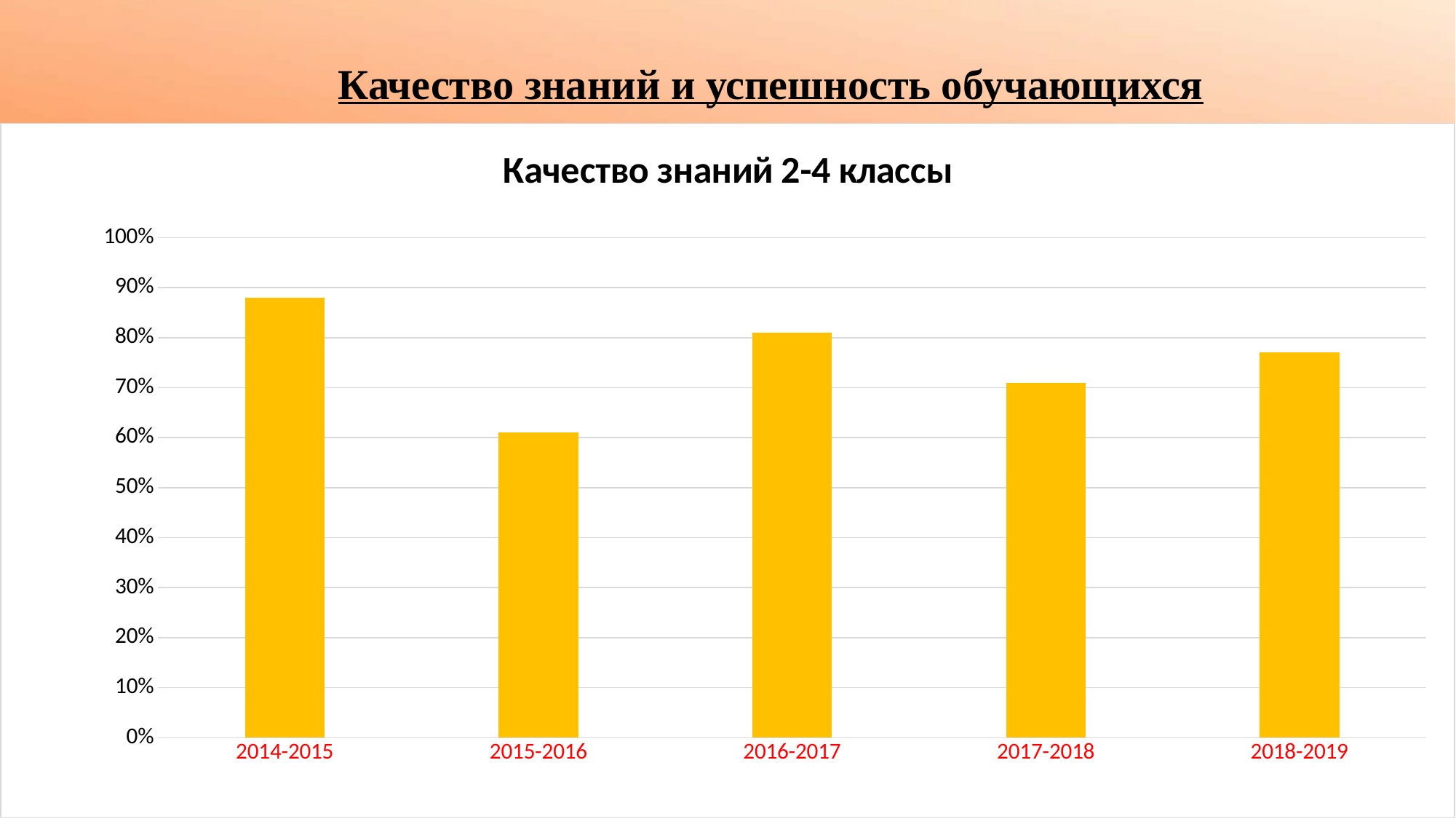
Which school year has the lowest value in the chart? 2015-2016 How many school years are shown on the x axis of the chart? 5 Which is larger, the value for 2016-2017 or the value for 2017-2018? 2016-2017 Is the value for 2014-2015 greater or less than 80%? greater Is the value for 2015-2016 greater or less than 70%? less Does the value rise or fall from 2014-2015 to 2015-2016? fall Which school year has the highest value in the chart? 2014-2015 What type of chart is shown on the slide? Bar chart Is the value for 2018-2019 greater or less than 70%? greater What is the title of the chart? Качество знаний 2-4 классы